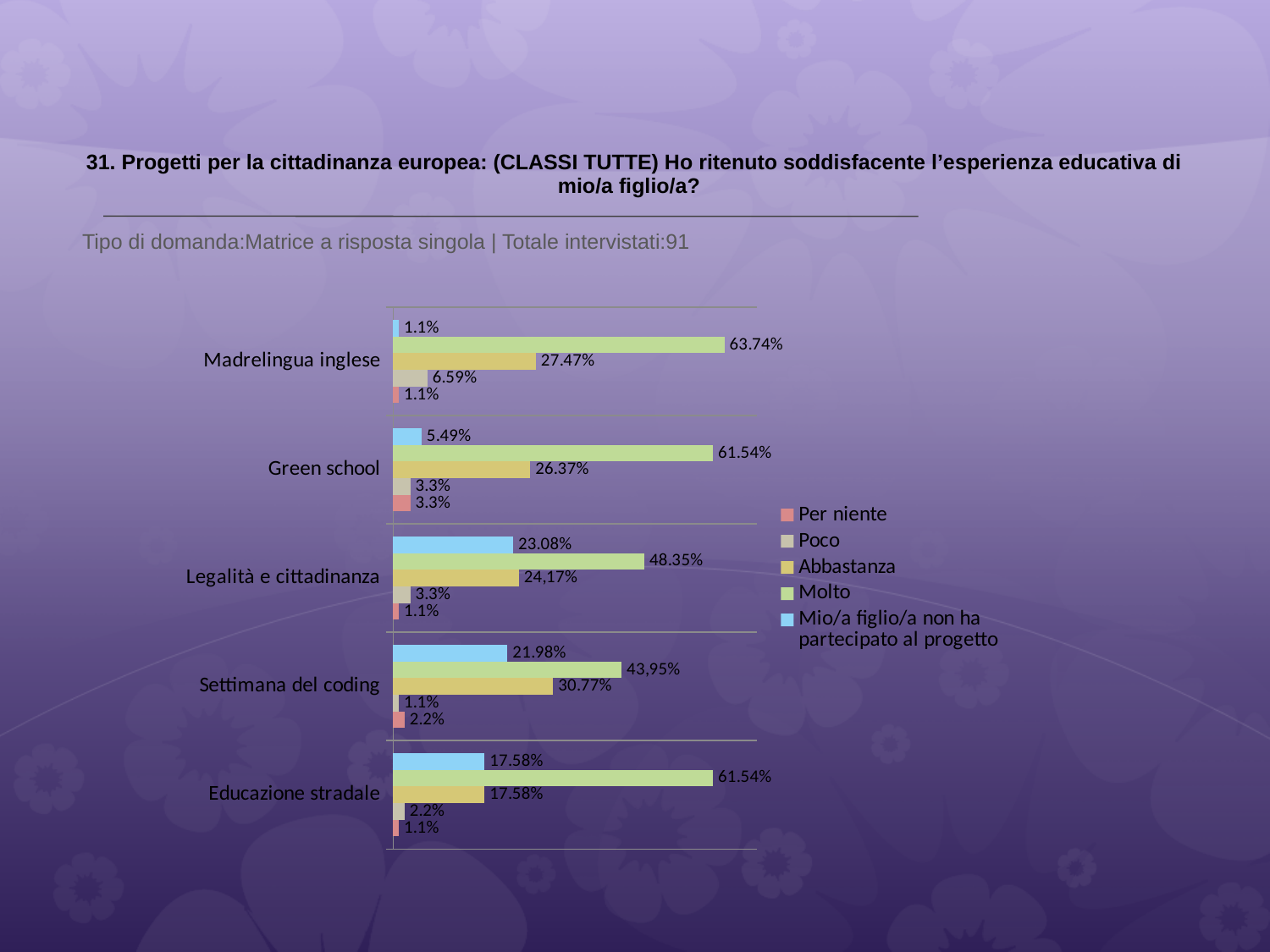
How many projects (categories) are shown on the chart? 5 What is the difference between the "Molto" values for Madrelingua inglese and Green school? 2.2 percentage points Which project has the highest value for "Molto"? Madrelingua inglese Which project has the lowest value for "Molto"? Settimana del coding What is the value of "Poco" for Madrelingua inglese? 6.59% How many series does the legend list? 5 What is the value of "Mio/a figlio/a non ha partecipato al progetto" for Legalità e cittadinanza? 23.08% What is the value of "Abbastanza" for Green school? 26.37% What kind of chart is shown on the slide? Bar chart Which has a larger "Abbastanza" value, Settimana del coding or Madrelingua inglese? Settimana del coding What is the value of "Molto" for Madrelingua inglese? 63.74% What is the value of "Per niente" for Settimana del coding? 2.2%